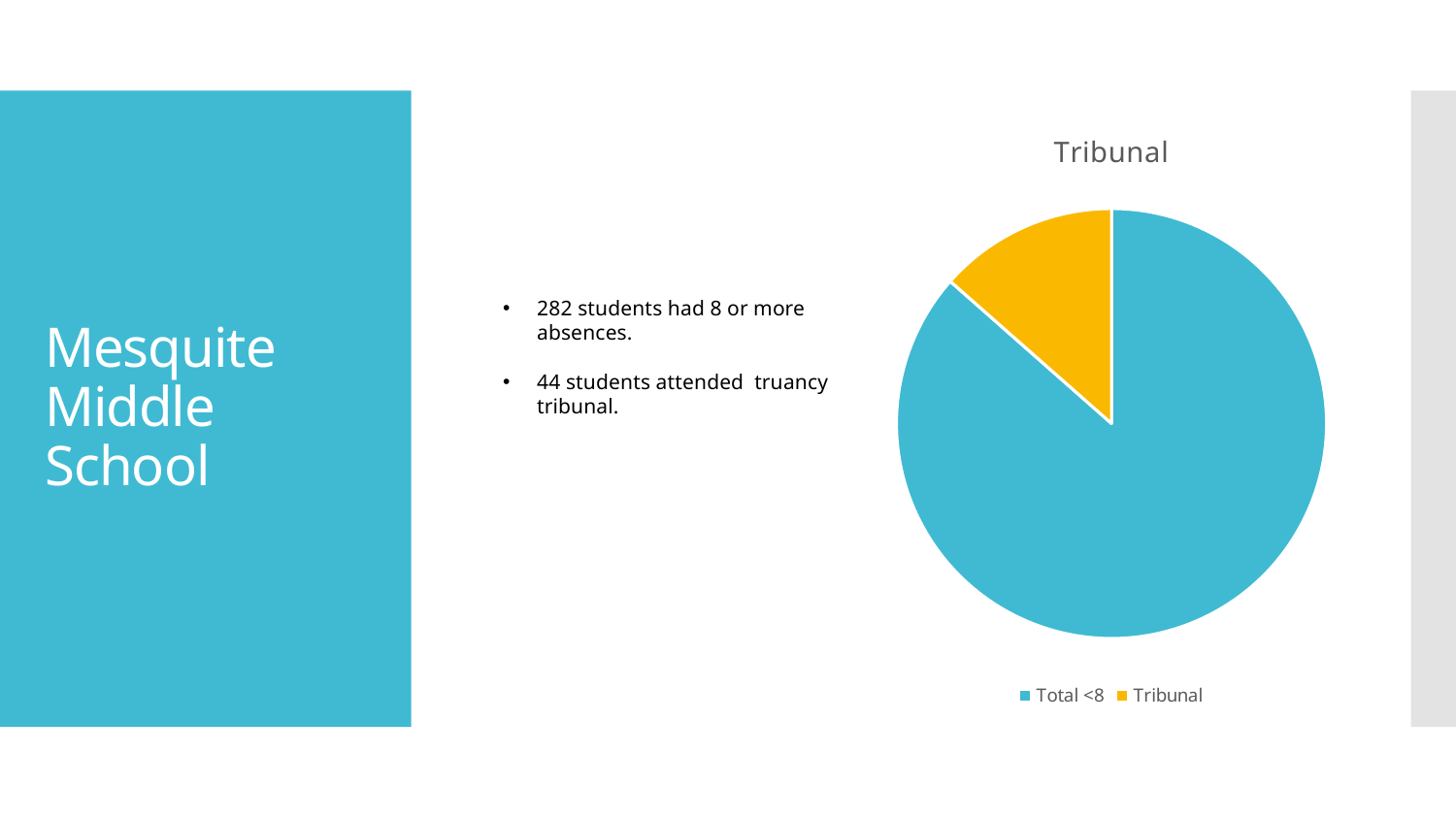
How many slices does the pie chart have? 2 What is the title of the pie chart? Tribunal How many entries does the legend of the pie chart list? 2 Which slice is larger in the pie chart, Total <8 or Tribunal? Total <8 What colour is the Tribunal slice in the pie chart? yellow What kind of chart is shown on the slide? pie chart Which slice of the pie chart is the smallest? Tribunal Which slice of the pie chart is the largest? Total <8